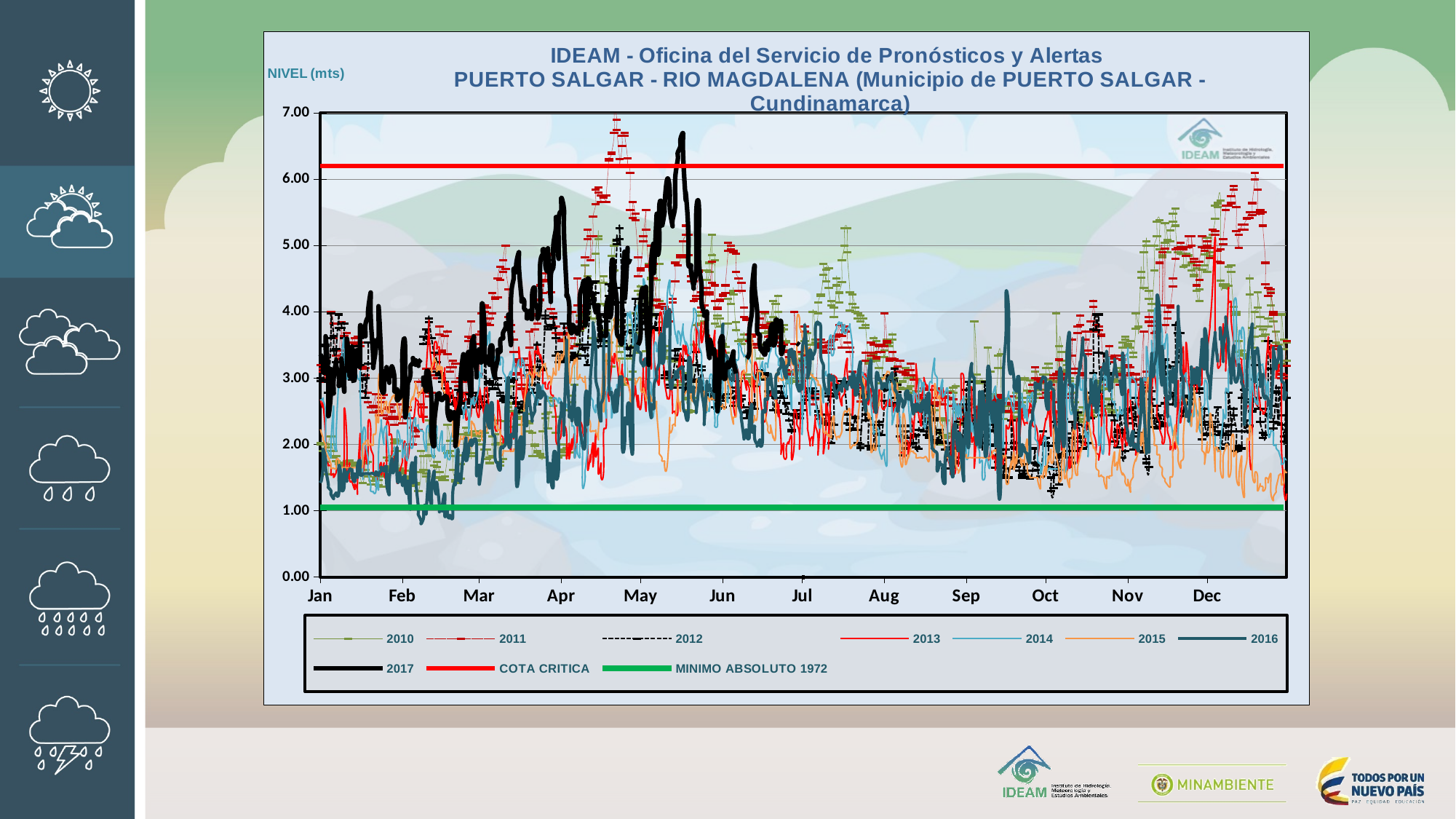
Is the value of the 2017 series at the start of January greater or less than 4.00? less How many months are labelled along the x axis? 12 Is the peak value of the 2017 series in May greater or less than 6.00? greater What is the label of the y axis? NIVEL (mts) What kind of chart is shown on the slide? line chart What is the highest value shown on the y axis? 7.00 Is the peak value of the 2017 series in May greater or less than 7.00? less How many series does the legend list? 10